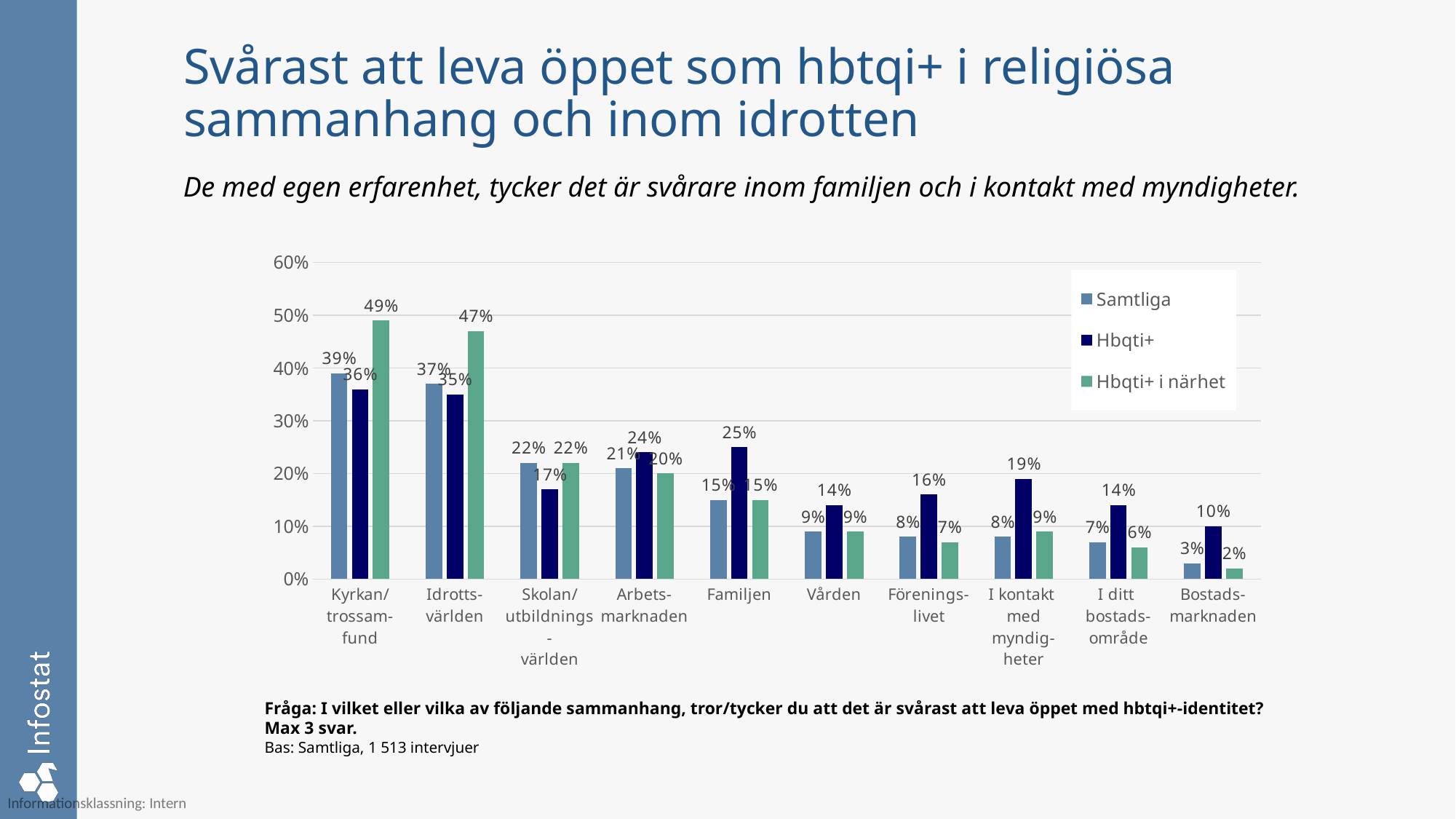
How many series does the legend list? 3 What is the value for Samtliga for Bostadsmarknaden? 3% Which category has the highest value for the Samtliga series? Kyrkan/trossamfund Which category has the lowest value for the Hbqti+ i närhet series? Bostadsmarknaden What is the value for Hbqti+ for Familjen? 25% For I kontakt med myndigheter, which is larger: the Hbqti+ value or the Samtliga value? Hbqti+ What is the difference between the Hbqti+ i närhet value and the Samtliga value for Idrottsvärlden? 10% Which series is shown in green in the legend? Hbqti+ i närhet What type of chart is shown on the slide? bar chart What is the difference between the Hbqti+ value and the Samtliga value for Föreningslivet? 8% How many categories are shown on the x axis? 10 What is the value for Hbqti+ i närhet for Kyrkan/trossamfund? 49%